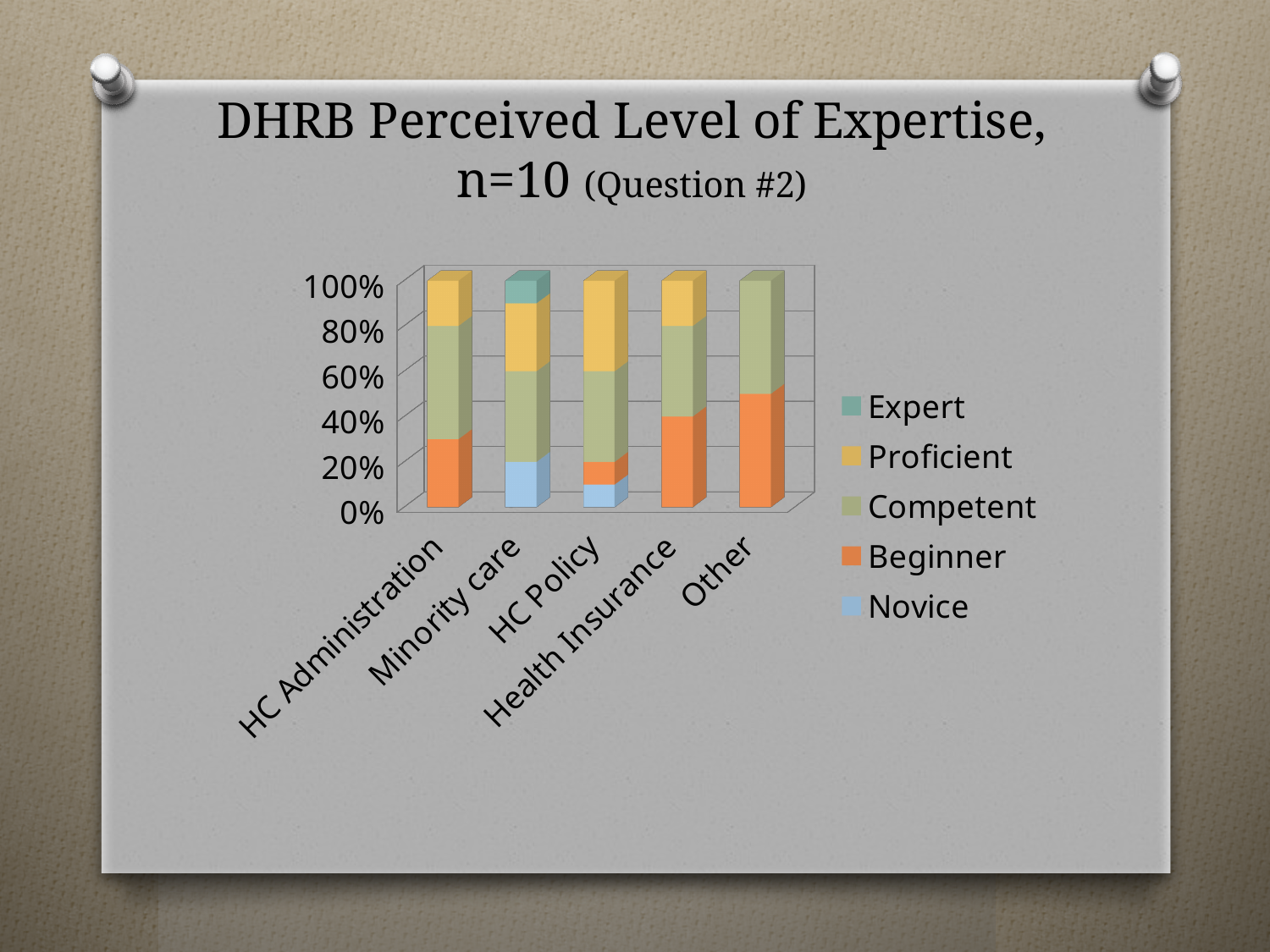
How many categories are shown on the x axis of the chart? 5 Which category has the largest Beginner share? Other What kind of chart is shown on the slide? Stacked bar chart Is the Beginner value for HC Administration greater or less than 40%? less Which category has the larger Beginner share, Other or HC Policy? Other Is the Beginner value for HC Administration greater or less than 20%? greater Is the Beginner value for Other greater or less than 40%? greater What is the title of the chart on the slide? DHRB Perceived Level of Expertise, n=10 (Question #2) What is the total of the stacked bar for Other? 100% How many series does the chart legend list? 5 Which category is the only one with an Expert segment? Minority care